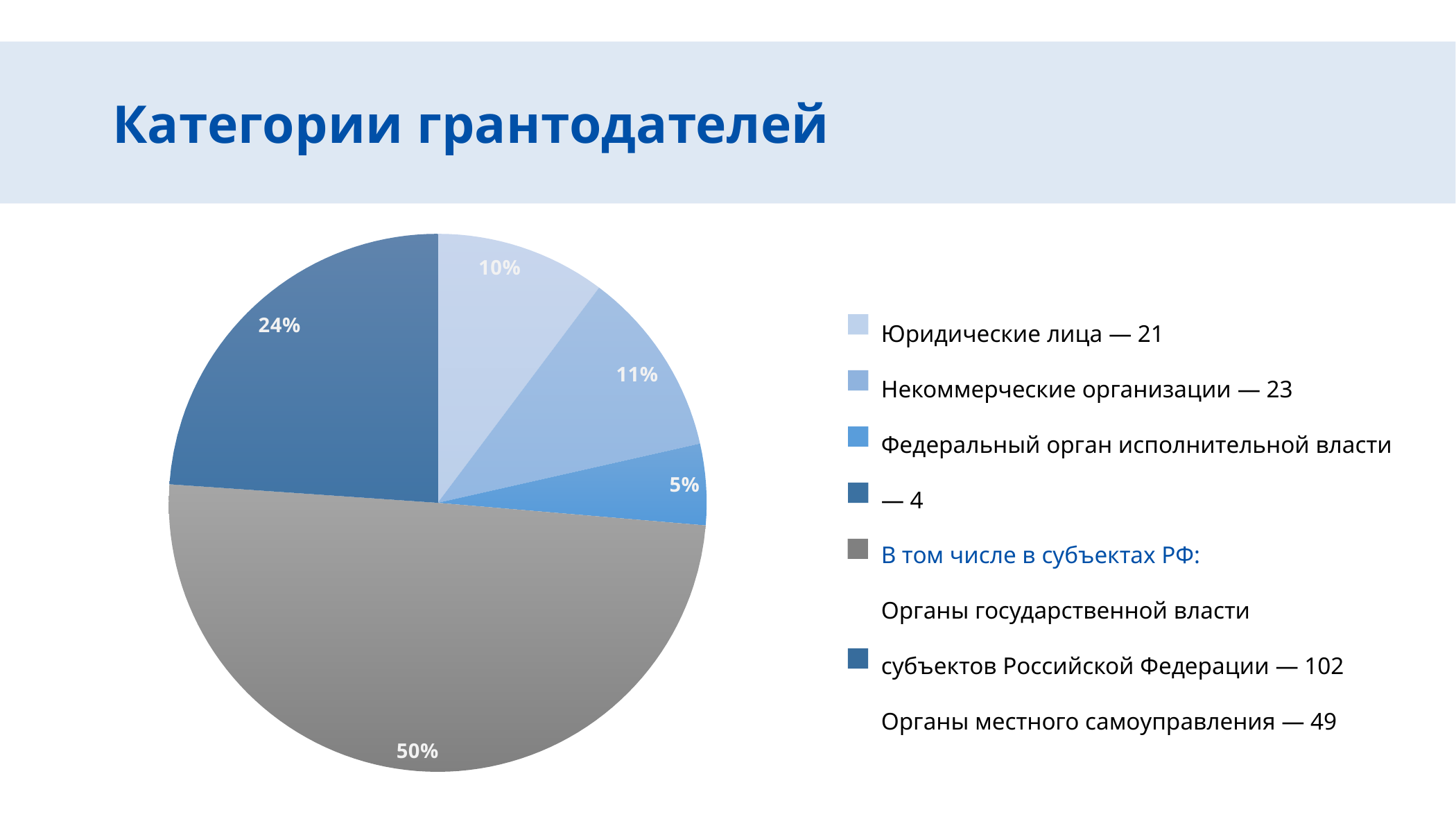
What share of the pie chart corresponds to Некоммерческие организации? 11% What is the title of the slide? Категории грантодателей How many slices does the pie chart have? 5 What is the difference in percentage points between the 50% slice and the 24% slice? 26 percentage points Which slice is larger: Юридические лица or Некоммерческие организации? Некоммерческие организации What is the share of the smallest slice in the pie chart? 5% According to the legend, how many Органы местного самоуправления are there? 49 What type of chart is shown on the slide? Pie chart What share of the pie chart corresponds to Юридические лица? 10% What share of the pie chart corresponds to Федеральный орган исполнительной власти? 5% According to the legend, how many Юридические лица are there? 21 What is the share of the largest slice in the pie chart? 50%